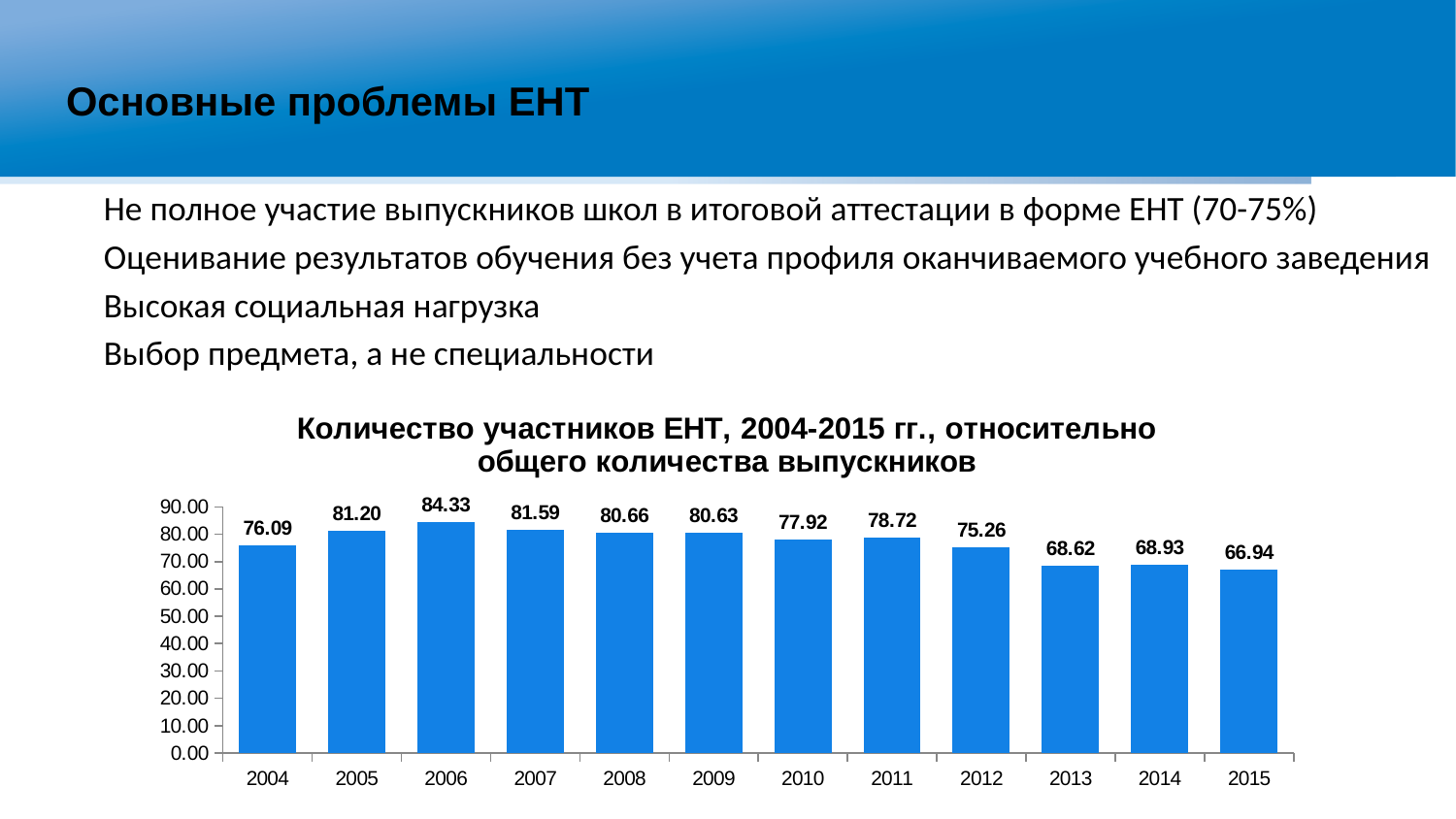
Which year has the highest value? 2006 What is the value for 2010? 77.92 What is the title of the chart? Количество участников ЕНТ, 2004-2015 гг., относительно общего количества выпускников What is the difference between the values for 2006 and 2015? 17.39 Do the values generally rise or fall from 2009 to 2015? fall Which is larger, the value for 2004 or the value for 2012? 2004 Which year has the lowest value? 2015 What is the value for 2015? 66.94 How many years are shown on the x axis? 12 What kind of chart is this? bar chart What is the value for 2006? 84.33 Is the value for 2013 greater or less than 70.00? less